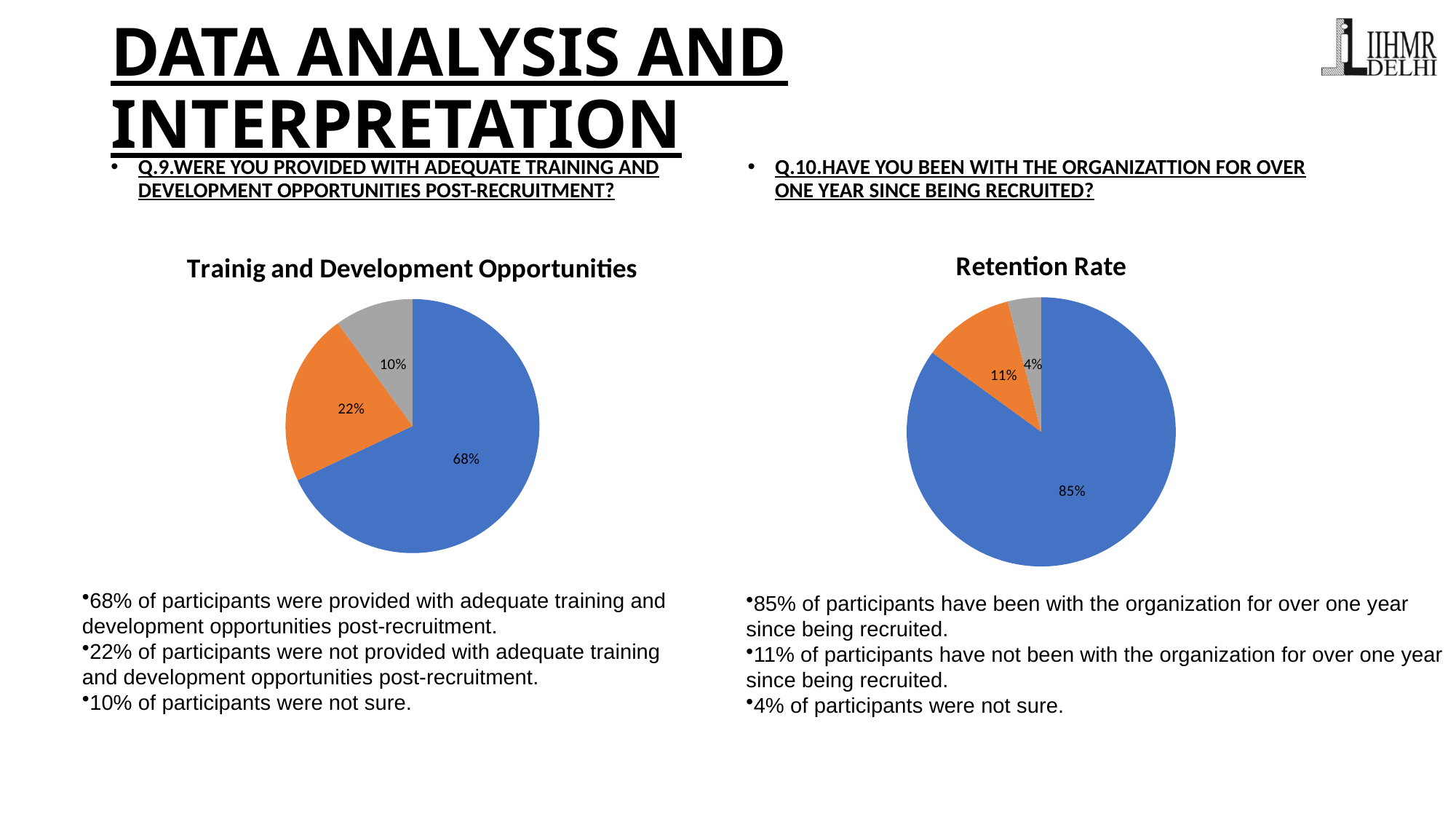
What is the title of the pie chart on the right side of the slide? Retention Rate In the "Trainig and Development Opportunities" pie chart, what is the value of the smallest slice? 10% In the "Retention Rate" pie chart, what is the value of the orange slice? 11% In the "Retention Rate" pie chart, what is the difference between the 85% slice and the 11% slice? 74% In the "Trainig and Development Opportunities" pie chart, what is the value of the largest slice? 68% In the "Trainig and Development Opportunities" pie chart, what is the difference between the 68% slice and the 22% slice? 46% How many slices does the "Trainig and Development Opportunities" pie chart have? 3 In the "Retention Rate" pie chart, what is the value of the smallest slice? 4% How many slices does the "Retention Rate" pie chart have? 3 What type of chart is the "Trainig and Development Opportunities" chart? Pie chart In the "Retention Rate" pie chart, what is the value of the largest slice? 85% Which is larger: the grey slice in the "Trainig and Development Opportunities" chart or the grey slice in the "Retention Rate" chart? Trainig and Development Opportunities (10%)